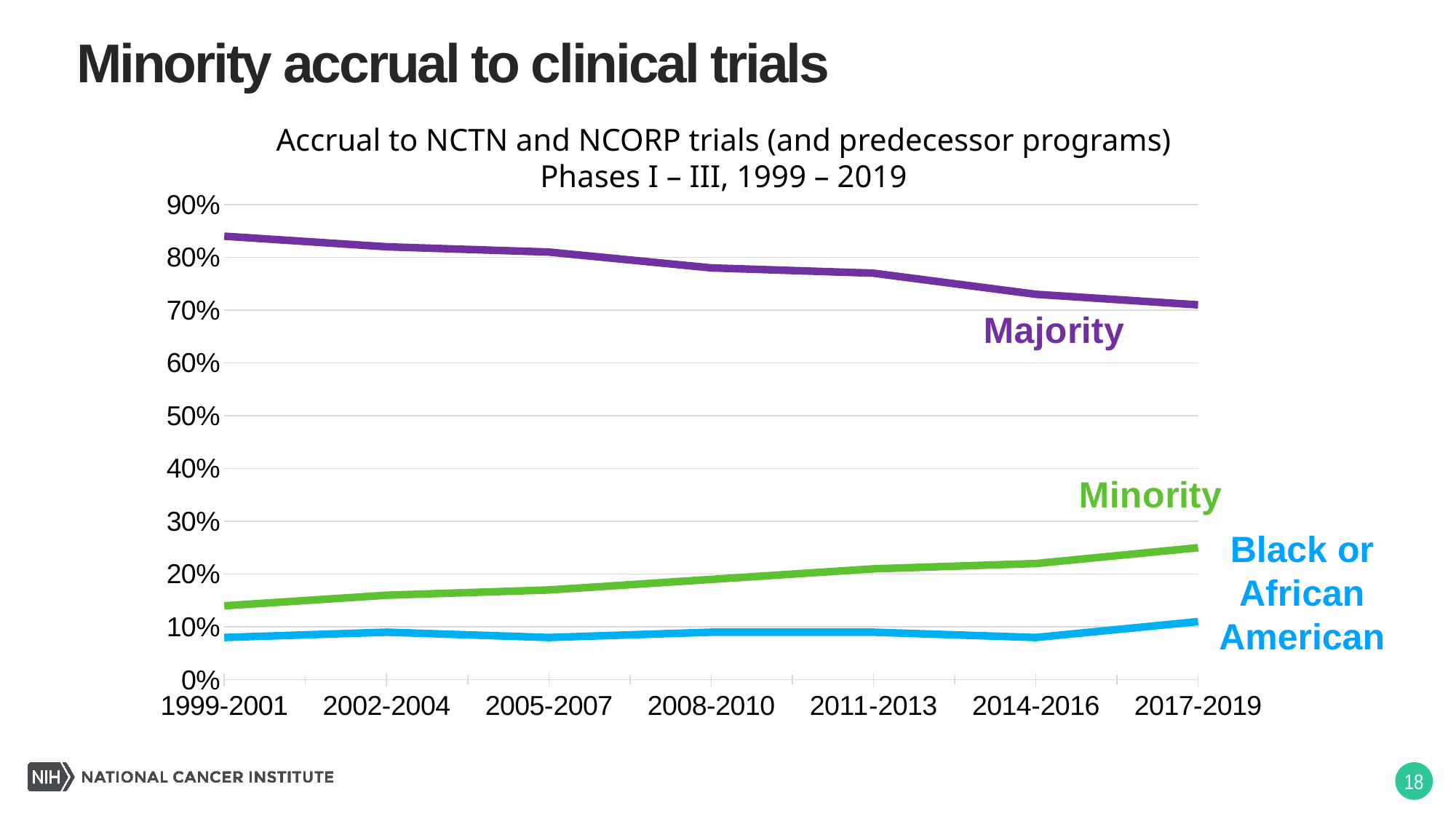
What kind of chart is shown on the slide? line chart What is the first line of the chart's title? Accrual to NCTN and NCORP trials (and predecessor programs) Does the Minority line rise or fall from 1999-2001 to 2017-2019? rise Is the Minority value for 2017-2019 greater or less than 20%? greater Is the Majority value for 1999-2001 greater or less than 80%? greater How many series are plotted on the chart? 3 How many time periods are shown on the x axis? 7 Is the Black or African American value for 2017-2019 greater or less than 20%? less Which series has the highest values across the whole chart? Majority Does the Majority line rise or fall from 1999-2001 to 2017-2019? fall In which period is the Minority value highest? 2017-2019